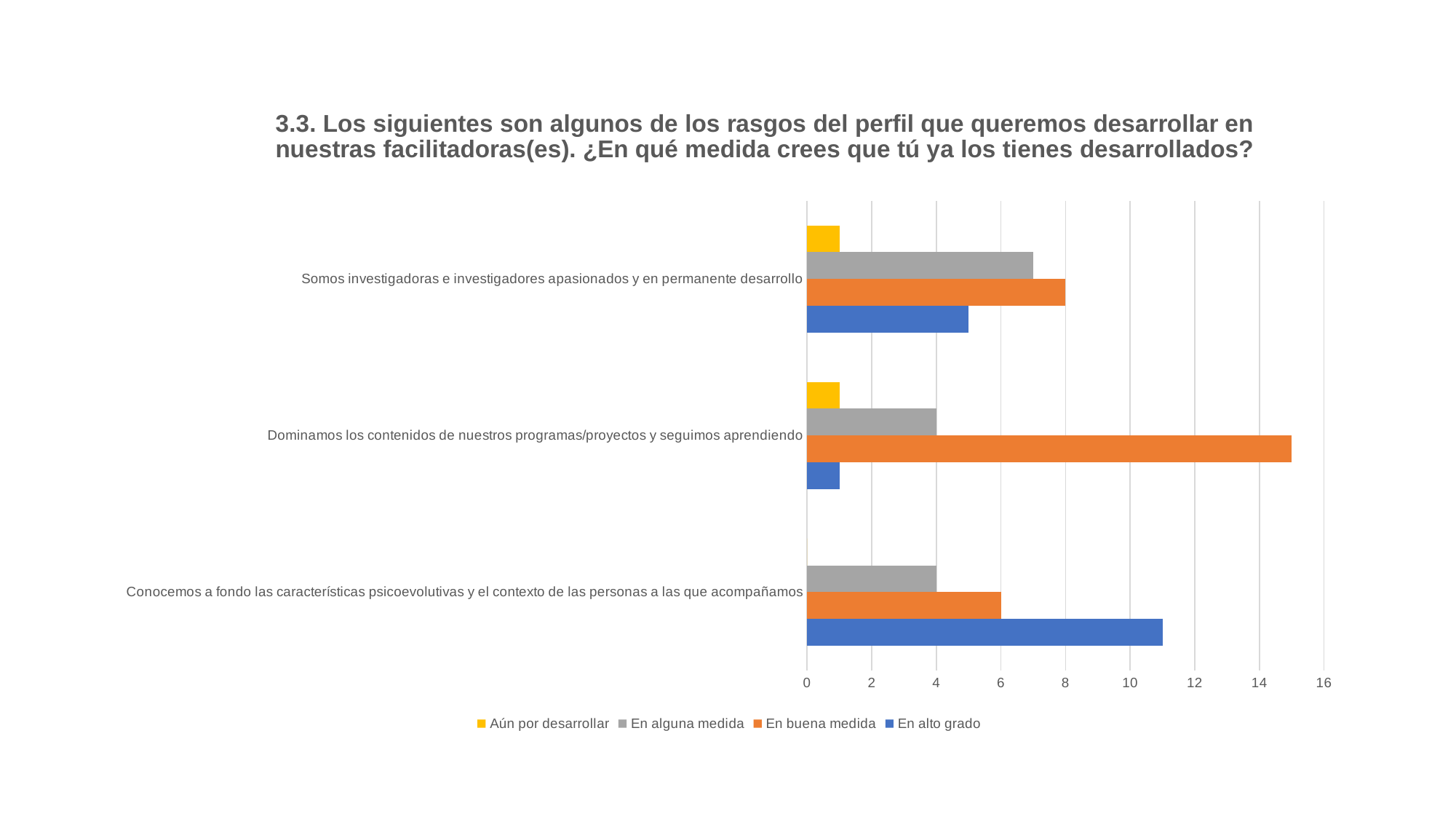
For 'Conocemos a fondo las características psicoevolutivas y el contexto de las personas a las que acompañamos', which series has the highest value? En alto grado Which is larger: 'En alto grado' for 'Somos investigadoras e investigadores apasionados y en permanente desarrollo' or 'En alto grado' for 'Dominamos los contenidos de nuestros programas/proyectos y seguimos aprendiendo'? Somos investigadoras e investigadores apasionados y en permanente desarrollo What is the difference between the 'En buena medida' values for 'Somos investigadoras e investigadores apasionados y en permanente desarrollo' and 'Conocemos a fondo las características psicoevolutivas y el contexto de las personas a las que acompañamos'? 2 Is the value of 'En alto grado' for 'Conocemos a fondo las características psicoevolutivas y el contexto de las personas a las que acompañamos' greater or less than 10? greater How many series does the legend list? 4 What is the value of 'En alguna medida' for 'Dominamos los contenidos de nuestros programas/proyectos y seguimos aprendiendo'? 4 How many categories (statements) are plotted on the chart? 3 Which category has the longest bar overall on the chart? Dominamos los contenidos de nuestros programas/proyectos y seguimos aprendiendo What is the value of 'En buena medida' for 'Somos investigadoras e investigadores apasionados y en permanente desarrollo'? 8 What kind of chart is shown on the slide? bar chart Is the value of 'En buena medida' for 'Dominamos los contenidos de nuestros programas/proyectos y seguimos aprendiendo' greater or less than 14? greater What is the value of 'En buena medida' for 'Conocemos a fondo las características psicoevolutivas y el contexto de las personas a las que acompañamos'? 6